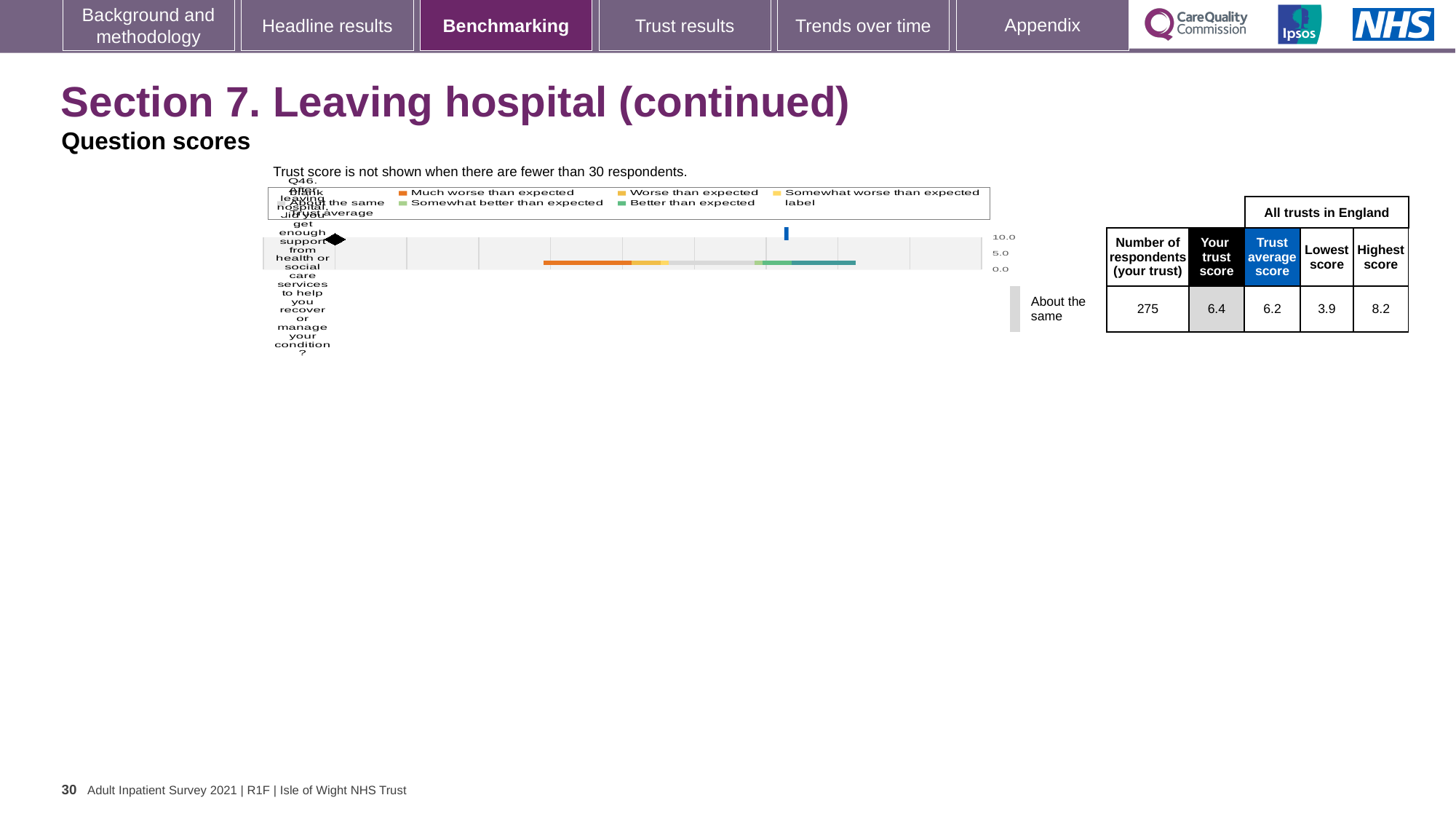
What benchmark category is the trust's Q46 score placed in? About the same Which is larger for Q46: the trust's own score or the trust average score? the trust's own score How many respondents from the trust answered Q46? 275 What is the trust average score for Q46 shown in the table? 6.2 What is the highest score among all trusts in England for Q46? 8.2 Is the trust's score for Q46 greater or less than 5.0 on the chart's axis? greater What is the lowest score among all trusts in England for Q46? 3.9 What is the difference between the highest and lowest scores for Q46 across all trusts in England? 4.3 What kind of chart is shown on the slide? bar chart How many questions (categories) are plotted in the chart? 1 What is the highest value shown on the chart's score axis? 10.0 What is the trust's score for Q46 according to the table next to the chart? 6.4